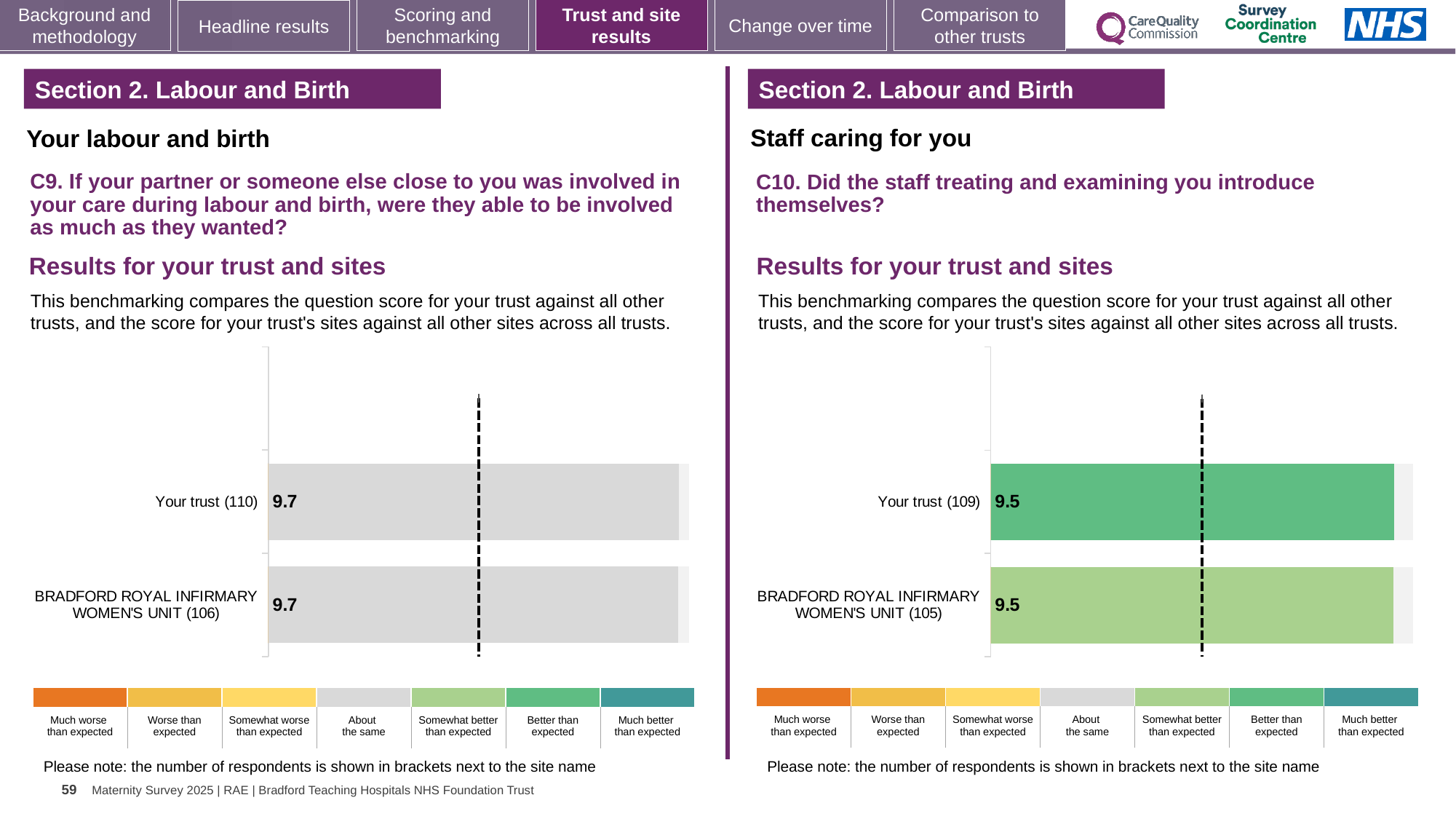
In the C9 chart on the left, what is the difference between the score for Your trust and the score for Bradford Royal Infirmary Women's Unit? 0 In the C10 chart on the right, what is the difference between the score for Your trust and the score for Bradford Royal Infirmary Women's Unit? 0 In the C10 chart on the right, what is the score for Your trust? 9.5 What type of chart is used for the C10 results on the right? Bar chart In the C9 chart on the left, how many respondents are shown in brackets for Your trust? 110 How many bars are plotted in the C9 chart on the left? 2 In the C10 chart on the right, what is the score for Bradford Royal Infirmary Women's Unit? 9.5 How many benchmarking categories does the colour legend below the C10 chart on the right list? 7 How many bars are plotted in the C10 chart on the right? 2 In the C10 chart on the right, how many respondents are shown in brackets for Bradford Royal Infirmary Women's Unit? 105 In the C9 chart on the left, what is the score for Bradford Royal Infirmary Women's Unit? 9.7 In the C9 chart on the left, what is the score for Your trust? 9.7